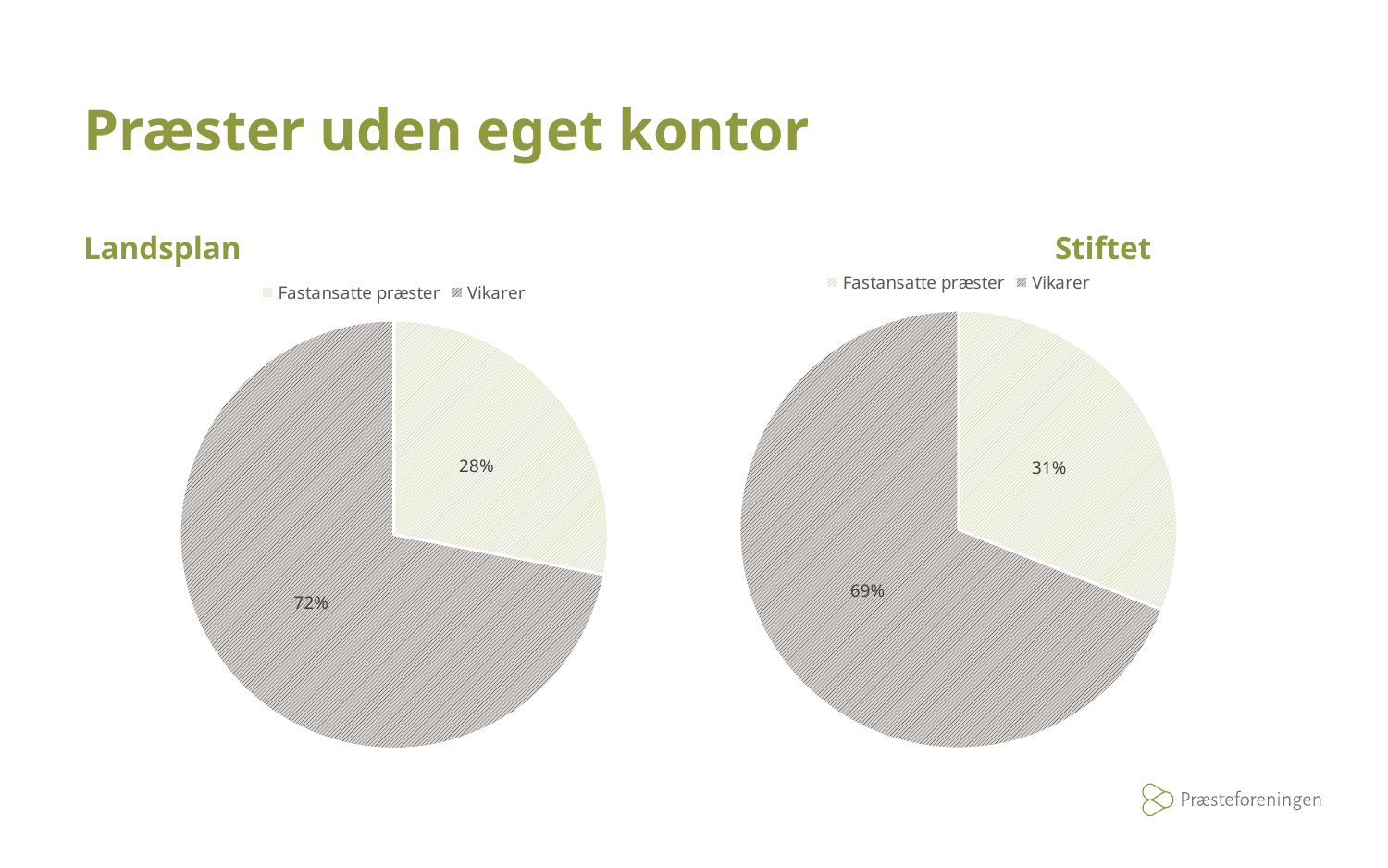
In the Stiftet pie chart, which slice is the smallest? Fastansatte præster How many entries does the legend of the Landsplan chart list? 2 In the Stiftet pie chart, what share is labelled for Vikarer? 69% In the Landsplan pie chart, what share is labelled for Fastansatte præster? 28% In the Landsplan pie chart, which slice is the largest? Vikarer Is the Fastansatte præster share larger in the Landsplan chart or in the Stiftet chart? Stiftet In the Stiftet pie chart, what share is labelled for Fastansatte præster? 31% What kind of chart is the Landsplan chart? Pie chart In the Landsplan pie chart, what is the difference between the Vikarer share and the Fastansatte præster share? 44% How many slices does the Stiftet pie chart have? 2 In the Landsplan pie chart, what share is labelled for Vikarer? 72% In the Stiftet pie chart, what is the difference between the Vikarer share and the Fastansatte præster share? 38%